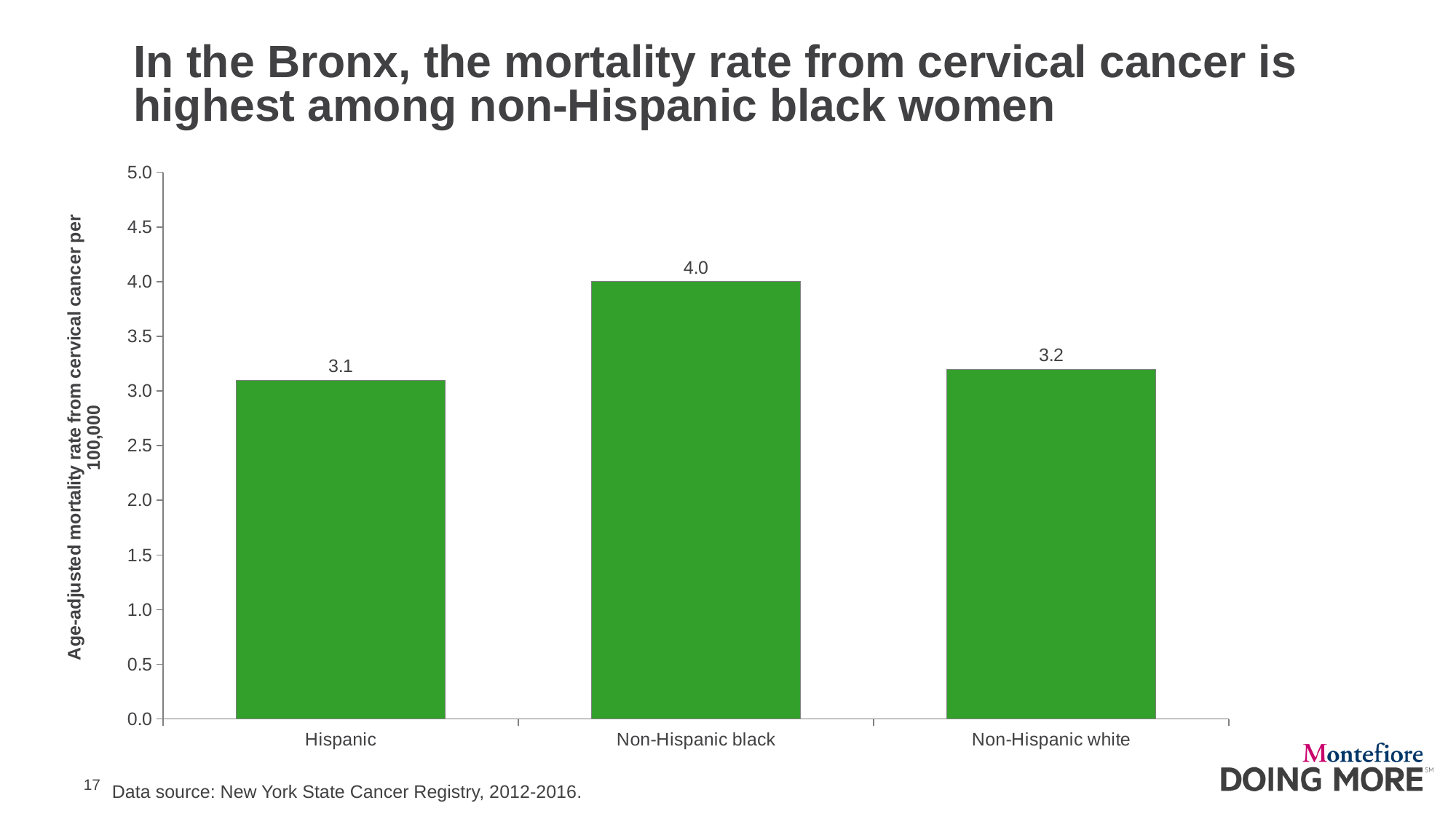
Which group has the highest cervical cancer mortality rate? Non-Hispanic black What is the difference between the mortality rates for non-Hispanic black and non-Hispanic white women? 0.8 Which is larger, the mortality rate for non-Hispanic black women or for non-Hispanic white women? Non-Hispanic black Is the mortality rate for Hispanic women greater or less than 3.5? less How many groups are shown on the chart? 3 What is the age-adjusted cervical cancer mortality rate for non-Hispanic black women? 4.0 What kind of chart is shown on the slide? Bar chart What is the age-adjusted cervical cancer mortality rate for Hispanic women? 3.1 What is the difference between the mortality rates for non-Hispanic black and Hispanic women? 0.9 What is the label of the vertical axis? Age-adjusted mortality rate from cervical cancer per 100,000 What is the age-adjusted cervical cancer mortality rate for non-Hispanic white women? 3.2 Which group has the lowest cervical cancer mortality rate? Hispanic